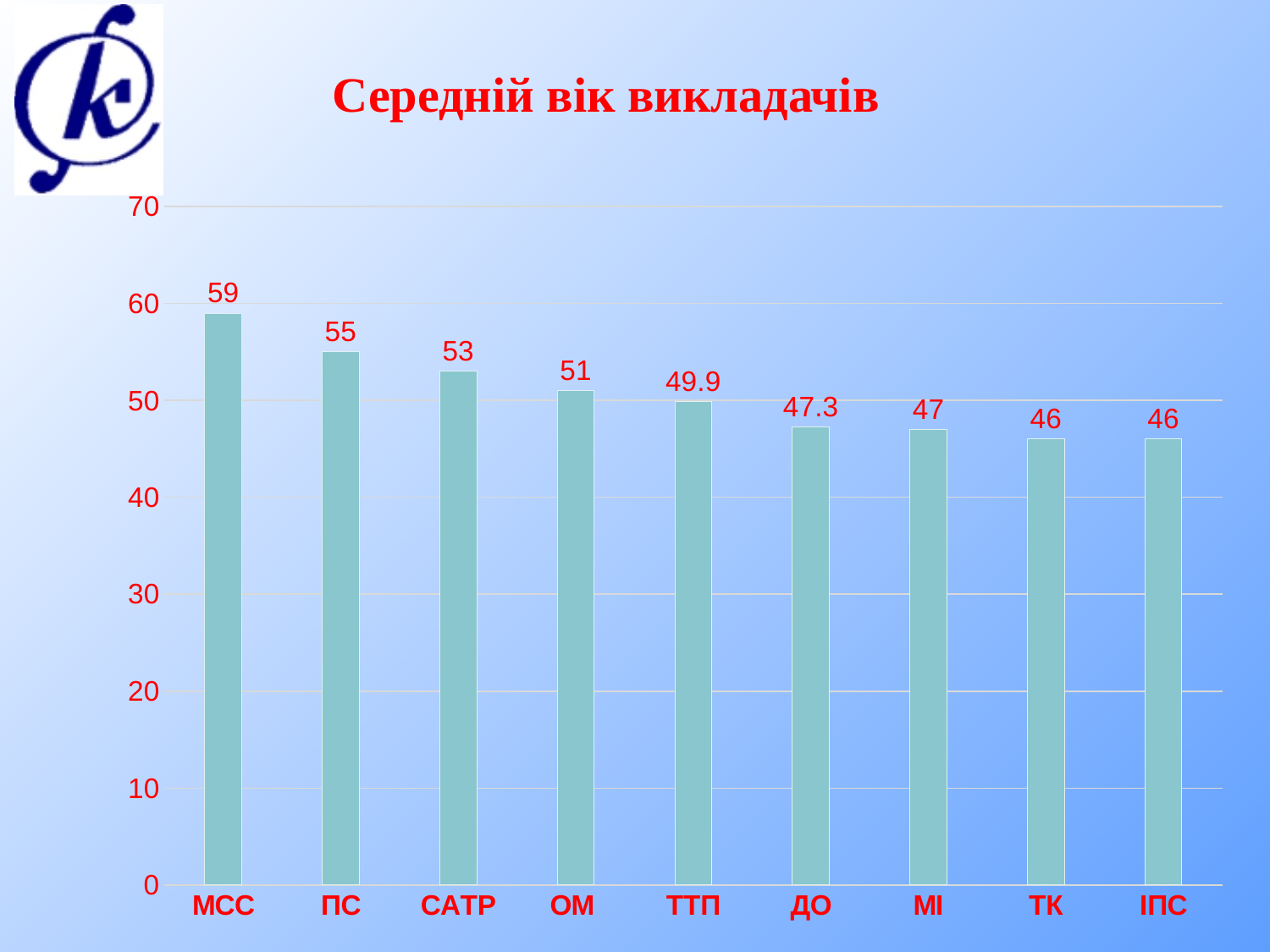
What is the difference between the values for МСС and ПС? 4 Which category has the highest value? МСС What kind of chart is shown on the slide? bar chart What value is shown for САТР? 53 Which is larger, the value for ПС or the value for ОМ? ПС What value is shown for ТТП? 49.9 Is the value for ТТП greater or less than 50? less What is the title of the chart? Середній вік викладачів How many categories are shown on the x axis? 9 What is the difference between the values for ОМ and МІ? 4 What is the average age shown for МСС? 59 What value is shown for ДО? 47.3